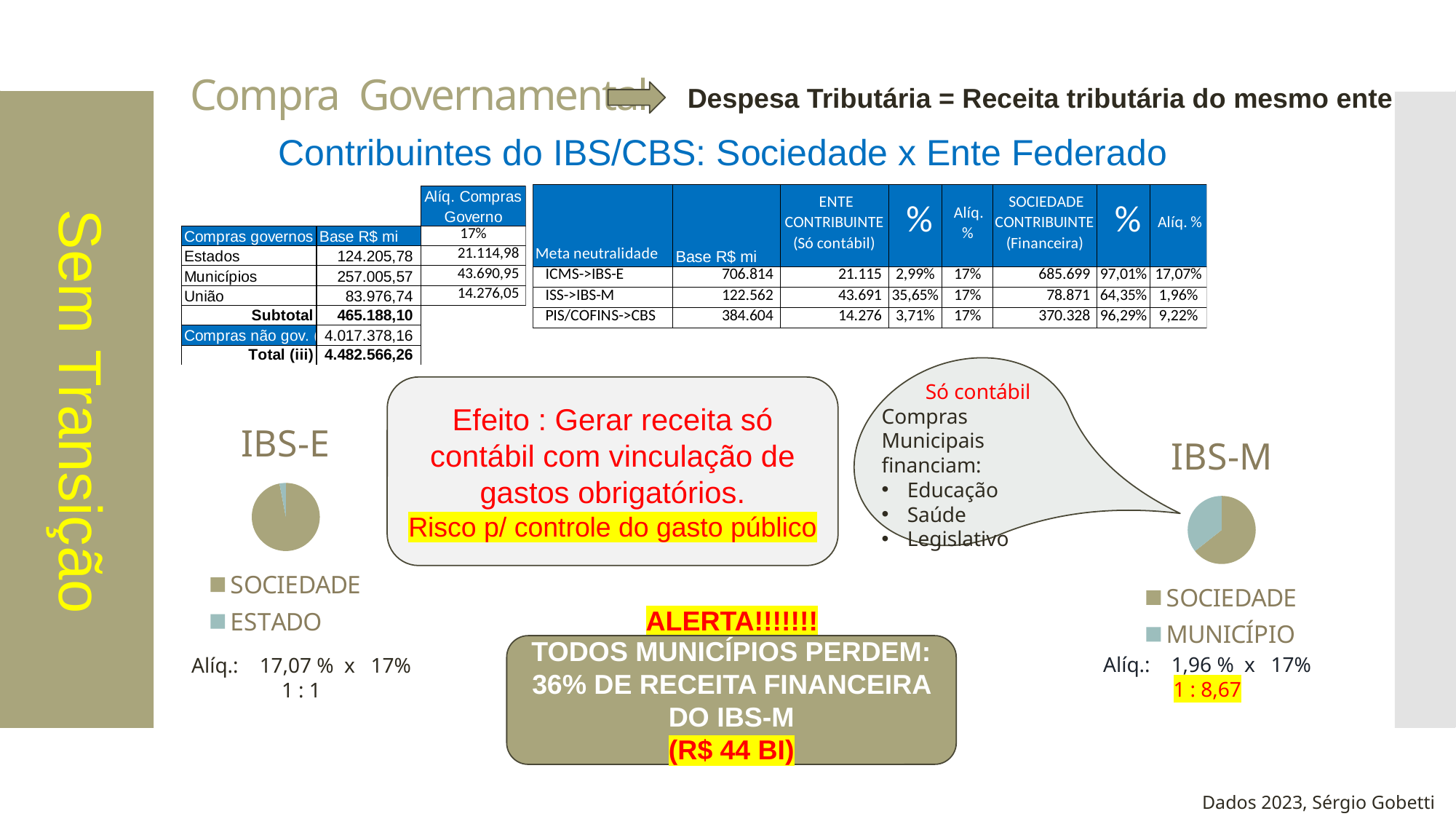
What kind of chart is the IBS-E chart on the left of the slide? pie chart What is the title shown above the pie chart on the left of the slide? IBS-E What kind of chart is the IBS-M chart on the right of the slide? pie chart In the IBS-M pie chart, is the SOCIEDADE slice larger or smaller than the MUNICÍPIO slice? larger How many slices does the IBS-M pie chart have? 2 How many entries does the legend of the IBS-M pie chart list? 2 How many entries does the legend of the IBS-E pie chart list? 2 In the IBS-M pie chart, which slice is the largest? SOCIEDADE In the IBS-M pie chart, which slice is the smallest? MUNICÍPIO In the IBS-E pie chart, which slice is the largest? SOCIEDADE In the IBS-E pie chart, which slice is the smallest? ESTADO What are the two legend entries of the IBS-M pie chart? SOCIEDADE and MUNICÍPIO